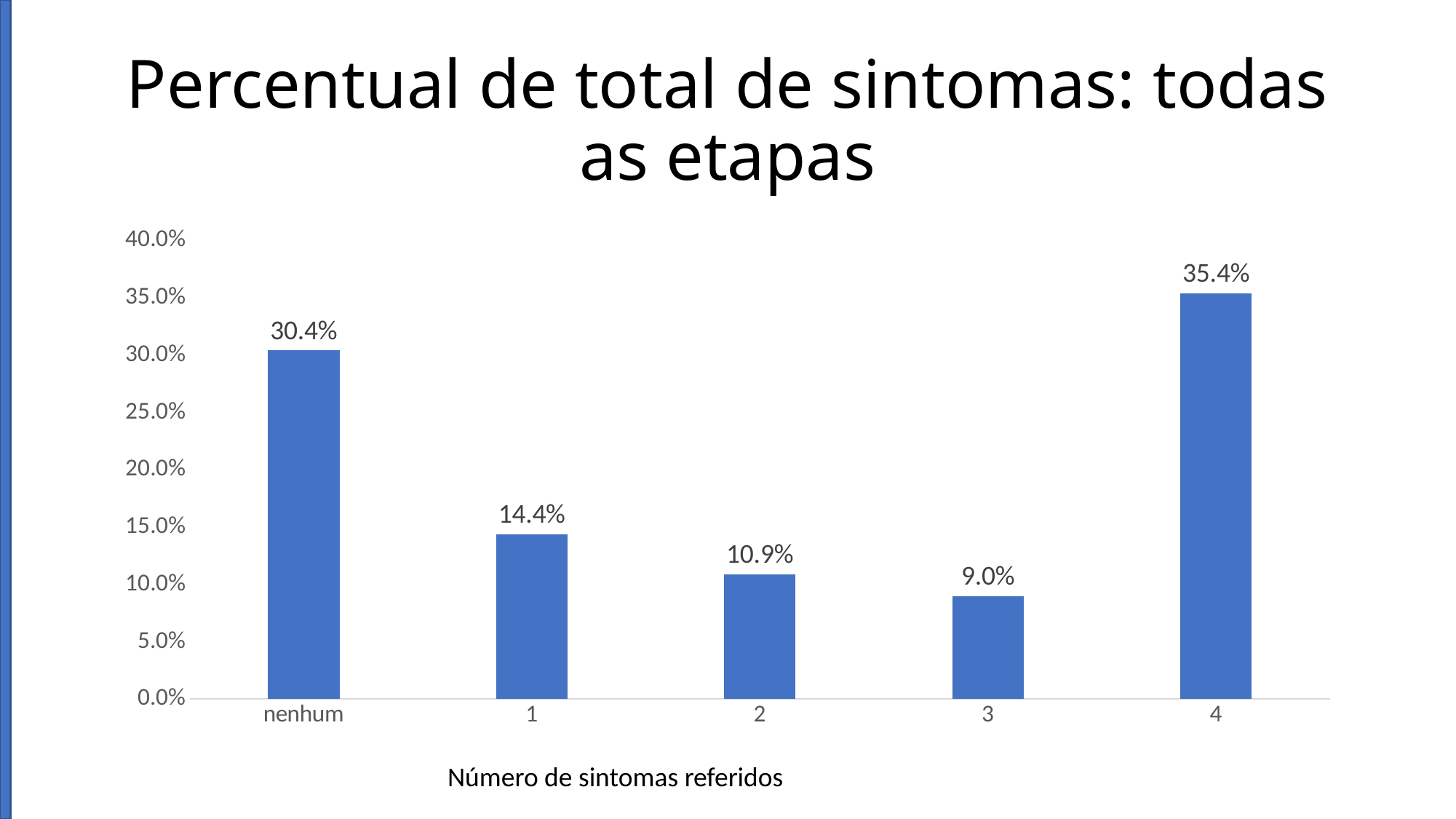
Which category has the highest value? 4 How many categories are shown on the x axis? 5 What is the value for the category "3"? 9.0% What is the value for the category "2"? 10.9% Which category has the lowest value? 3 Is the value for "4" greater or less than 35.0%? greater Which is larger, the value for "1" or the value for "3"? 1 What is the x-axis title of the chart? Número de sintomas referidos What kind of chart is shown on the slide? bar chart What is the value for the category "nenhum"? 30.4% What is the difference between the values for "4" and "nenhum"? 5.0% What is the difference between the values for "1" and "2"? 3.5%